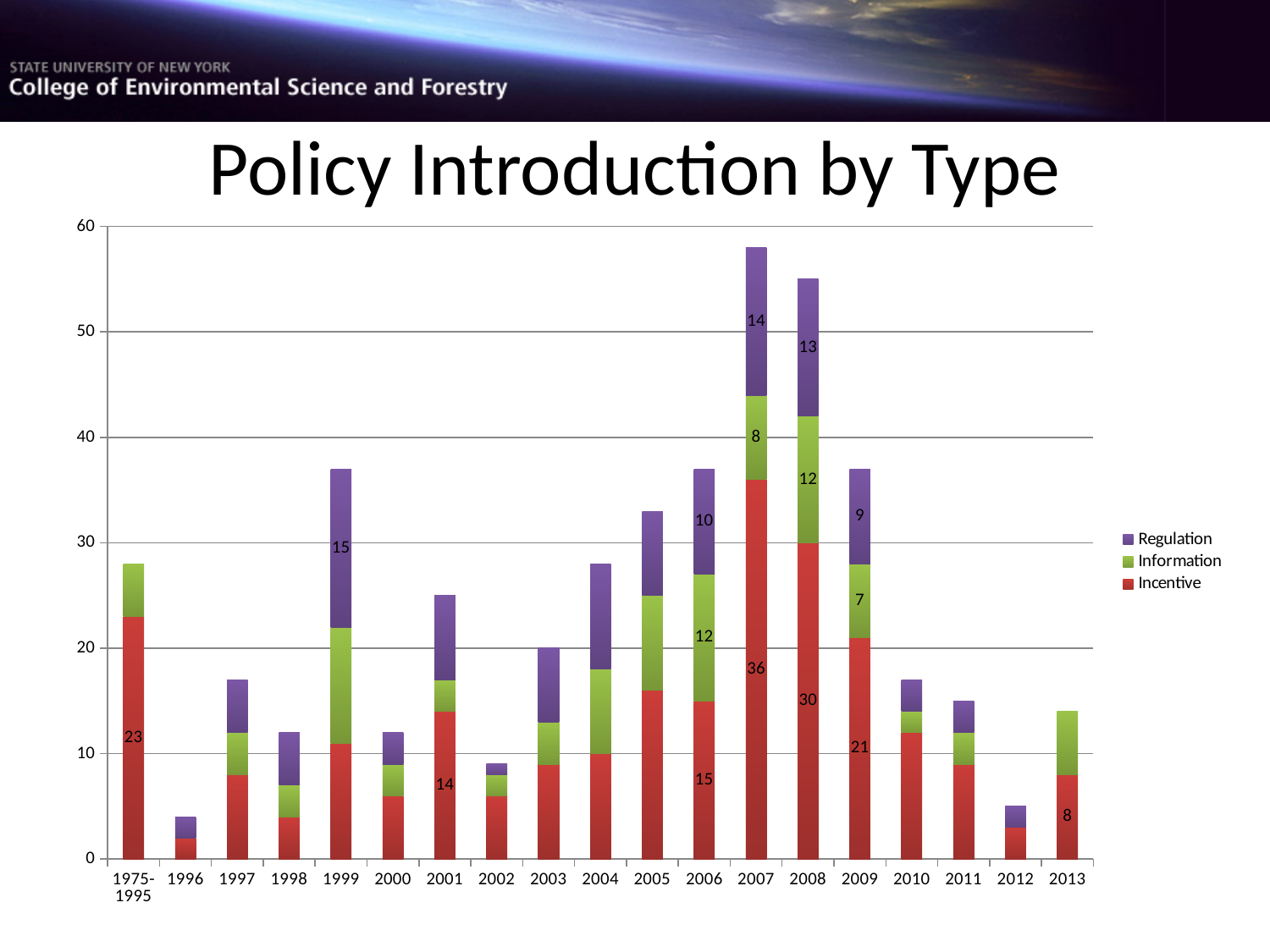
Which category has the shortest stacked bar? 1996 What is the Incentive value for 2013? 8 Which year has the tallest stacked bar? 2007 How many series does the legend list? 3 What is the Incentive value for 2007? 36 Is the total height of the 1999 bar greater or less than 30? greater What is the difference between the Incentive values for 2007 and 2008? 6 What is the total of the stacked bar for 2007? 58 What kind of chart is shown on the slide? Stacked bar chart How many categories are shown on the x axis? 19 Which is larger, the Information value for 2006 or for 2009? 2006 What is the Regulation value for 2008? 13